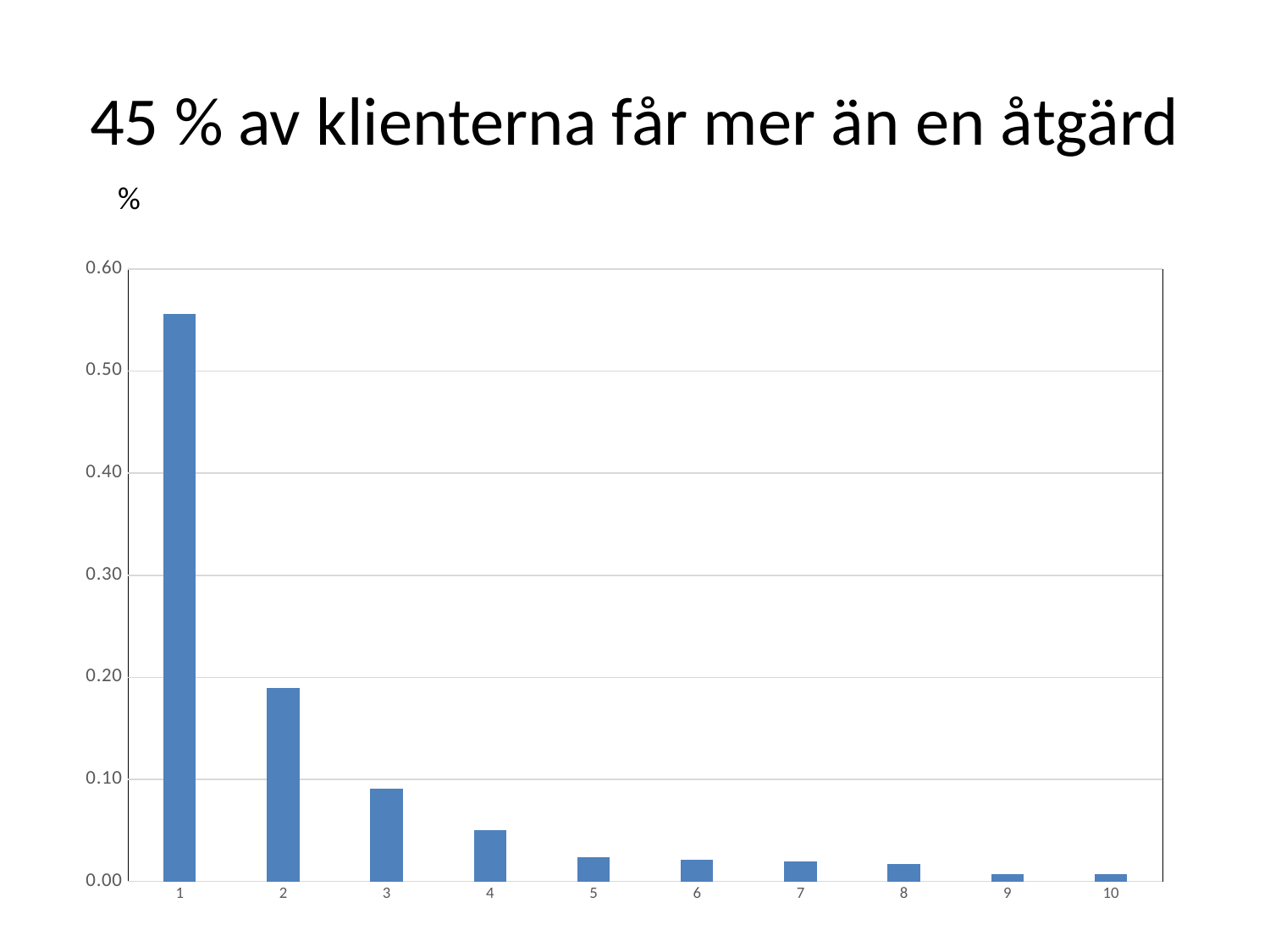
Which has the larger value, category 3 or category 4? 3 Is the value for category 4 greater or less than 0.10? less Which has the larger value, category 1 or category 2? 1 Do the values rise or fall as you move from category 1 to category 10 along the x axis? fall Is the value for category 1 greater or less than 0.50? greater Is the value for category 2 greater or less than 0.20? less What kind of chart is shown on the slide? bar chart Which category has the highest value in the chart? 1 What label is shown above the vertical axis of the chart? % How many categories are shown on the x axis of the chart? 10 What is the title of the slide containing the chart? 45 % av klienterna får mer än en åtgärd